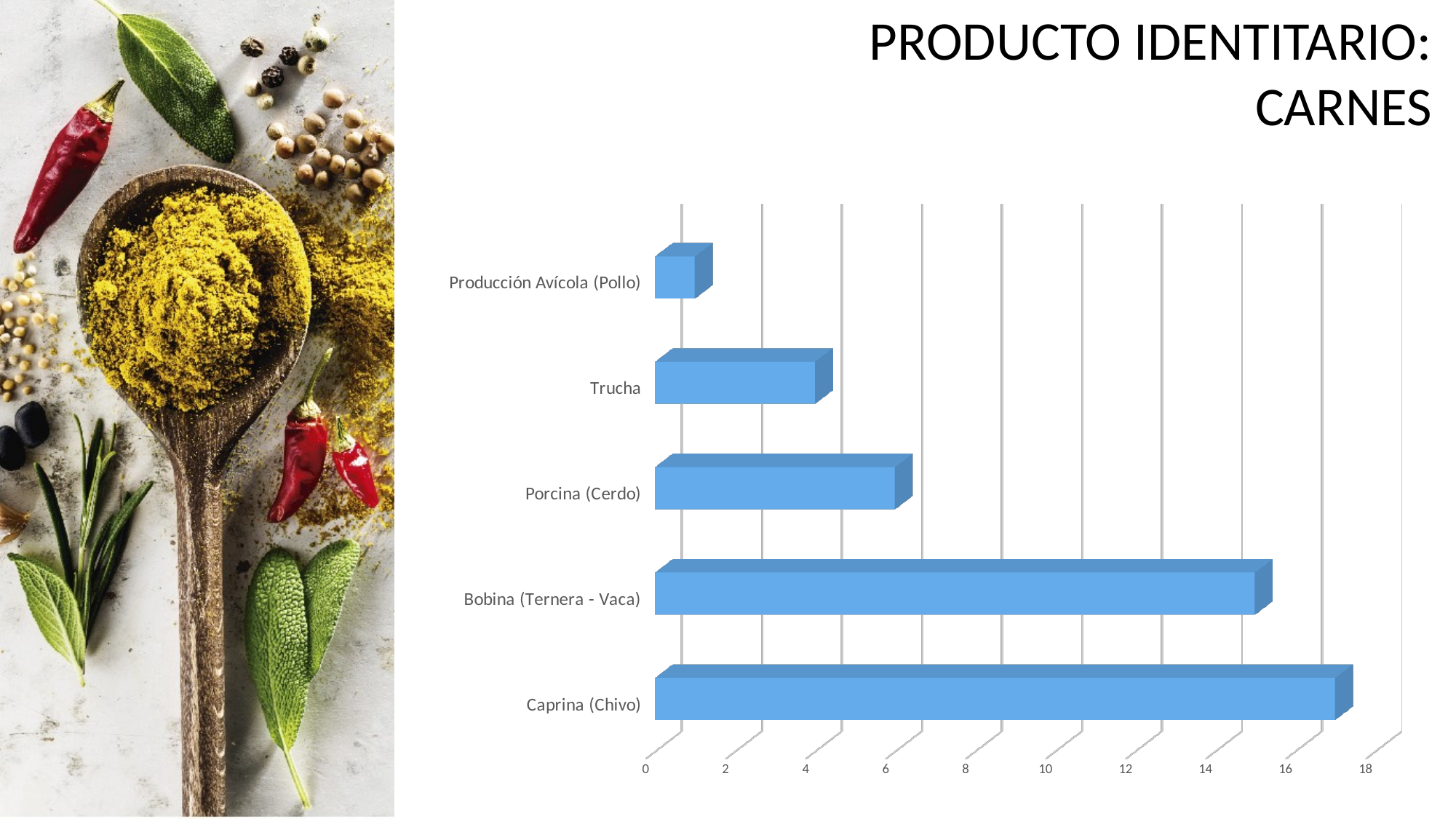
Is the value for Caprina (Chivo) greater or less than 16? greater How many categories are shown in the chart? 5 Which category has the highest value in the chart? Caprina (Chivo) Which category has the lowest value in the chart? Producción Avícola (Pollo) Is the value for Bobina (Ternera - Vaca) greater or less than 14? greater Is the value for Porcina (Cerdo) greater or less than 4? greater Which is larger, the value for Porcina (Cerdo) or the value for Trucha? Porcina (Cerdo) What is the title of the slide containing the chart? PRODUCTO IDENTITARIO: CARNES What kind of chart is shown on the slide? Bar chart